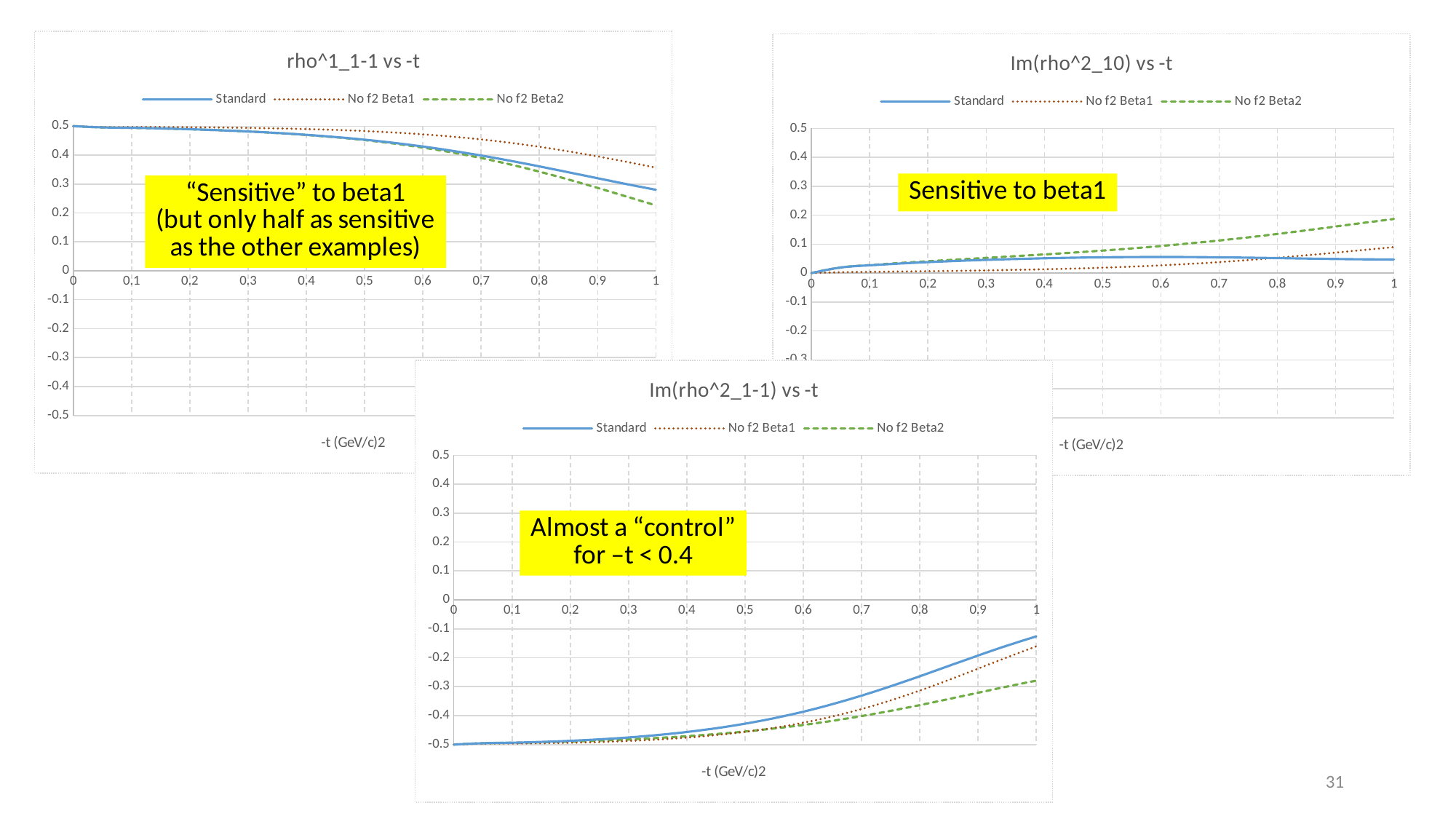
What kind of chart is the chart titled "rho^1_1-1 vs -t"? line chart In the chart titled "Im(rho^2_10) vs -t", is the value of the No f2 Beta2 series at -t = 1 greater or less than 0.1? greater How many series does the legend of the chart titled "Im(rho^2_10) vs -t" list? 3 In the chart titled "Im(rho^2_10) vs -t", do the values of the No f2 Beta2 series rise or fall as -t increases? rise In the chart titled "rho^1_1-1 vs -t", do the values of the Standard series rise or fall as -t increases? fall In the chart titled "Im(rho^2_10) vs -t", which series has the highest value at -t = 1? No f2 Beta2 In the chart titled "rho^1_1-1 vs -t", is the value of the No f2 Beta1 series at -t = 1 greater or less than 0.3? greater In the chart titled "Im(rho^2_1-1) vs -t", do the values of the Standard series rise or fall as -t increases? rise In the chart titled "Im(rho^2_1-1) vs -t", which series has the larger value at -t = 1, Standard or No f2 Beta2? Standard In the chart titled "Im(rho^2_1-1) vs -t", is the value of the No f2 Beta2 series at -t = 1 greater or less than -0.2? less In the chart titled "rho^1_1-1 vs -t", which series has the lowest value at -t = 1? No f2 Beta2 What is the x-axis label of the chart titled "Im(rho^2_1-1) vs -t"? -t (GeV/c)2